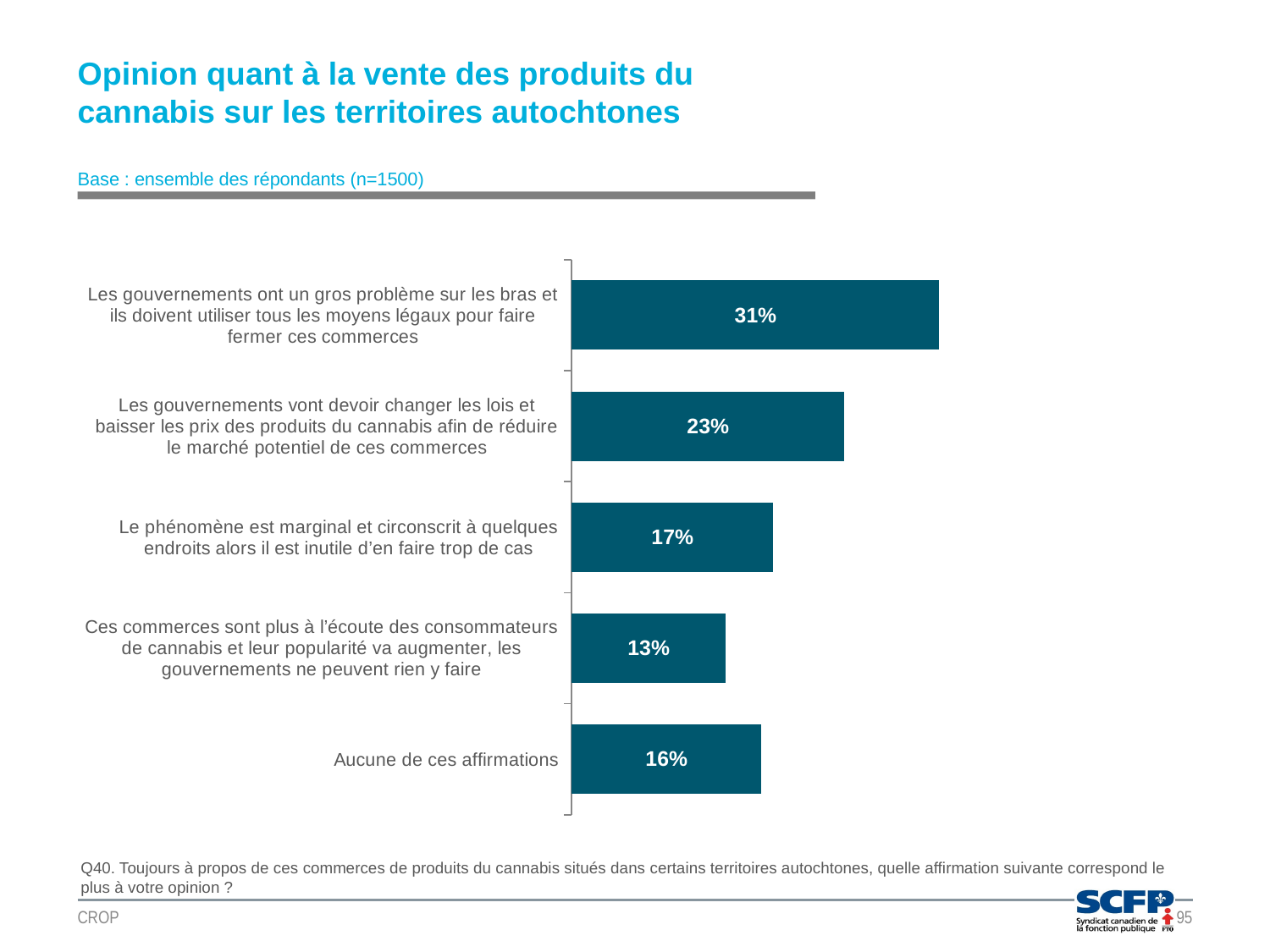
What type of chart is shown on the slide? Bar chart What is the title of the slide? Opinion quant à la vente des produits du cannabis sur les territoires autochtones Which is larger: the value for "Aucune de ces affirmations" or the value for "Ces commerces sont plus à l'écoute des consommateurs..."? Aucune de ces affirmations What percentage agreed that governments will have to change the laws and lower cannabis prices ("Les gouvernements vont devoir changer les lois...")? 23% What is the difference between the values for "Les gouvernements vont devoir changer les lois..." and "Le phénomène est marginal..."? 6% Which statement has the lowest percentage? Ces commerces sont plus à l'écoute des consommateurs de cannabis et leur popularité va augmenter, les gouvernements ne peuvent rien y faire What is the value for the statement "Le phénomène est marginal et circonscrit à quelques endroits alors il est inutile d'en faire trop de cas"? 17% Which statement has the highest percentage? Les gouvernements ont un gros problème sur les bras et ils doivent utiliser tous les moyens légaux pour faire fermer ces commerces What is the difference in percentage points between the top statement (31%) and "Aucune de ces affirmations"? 15% What is the base (number of respondents) indicated for the chart? n=1500 What percentage of respondents chose "Aucune de ces affirmations"? 16% How many statements (bars) are shown in the chart? 5